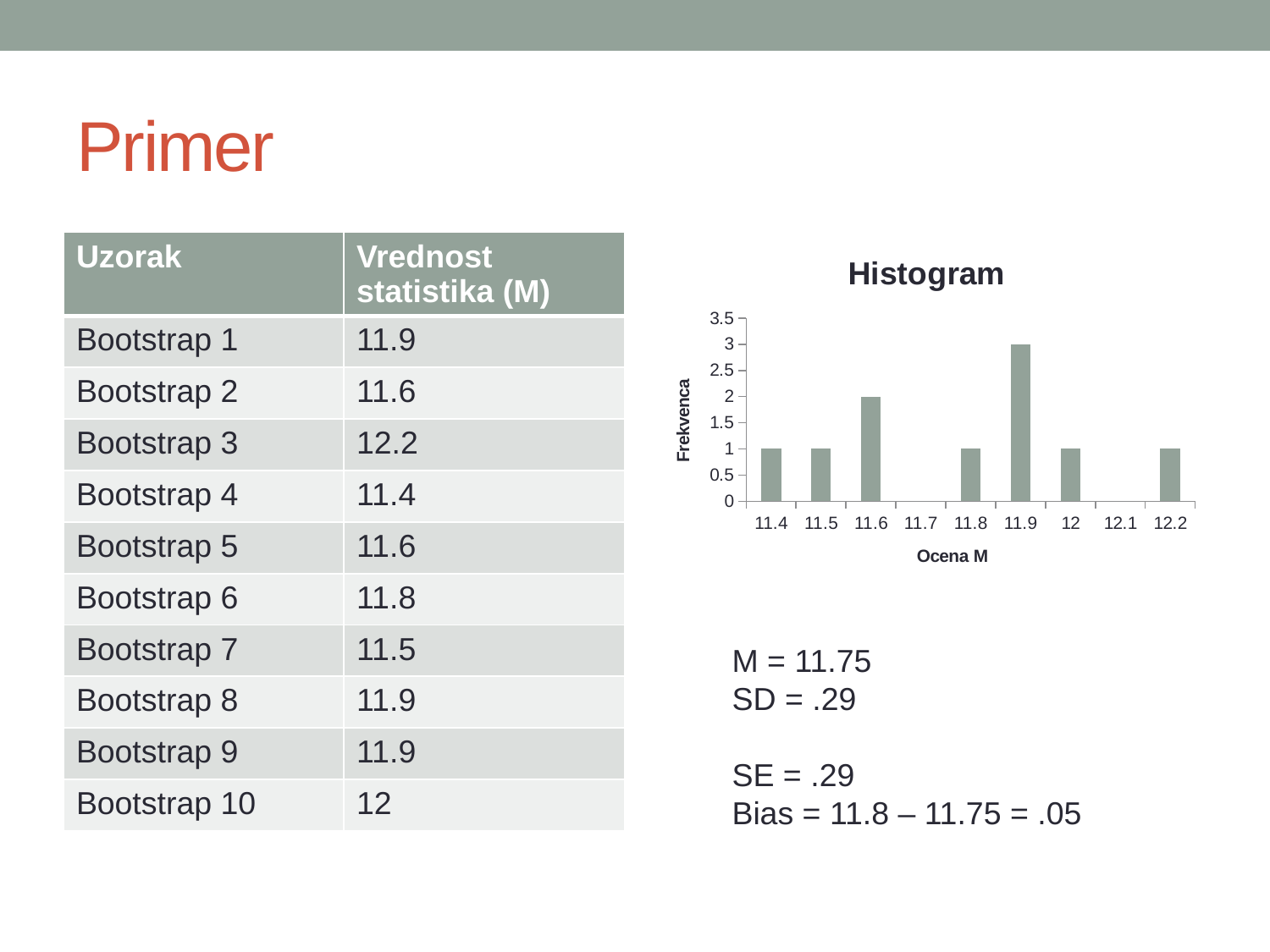
What is the frequency (Frekvenca) for Ocena M = 11.9? 3 What is the frequency (Frekvenca) for Ocena M = 11.7? 0 What is the difference between the frequency at 11.9 and the frequency at 11.6? 1 Which Ocena M value has the highest frequency? 11.9 Is the frequency for Ocena M = 11.9 greater or less than 2.5? greater What is the frequency (Frekvenca) for Ocena M = 11.4? 1 Which has a higher frequency, Ocena M = 11.6 or Ocena M = 12? 11.6 What is the title of the chart? Histogram What kind of chart is shown on the slide? bar chart How many Ocena M categories are shown on the x axis? 9 What is the label of the y axis? Frekvenca What is the frequency (Frekvenca) for Ocena M = 11.6? 2